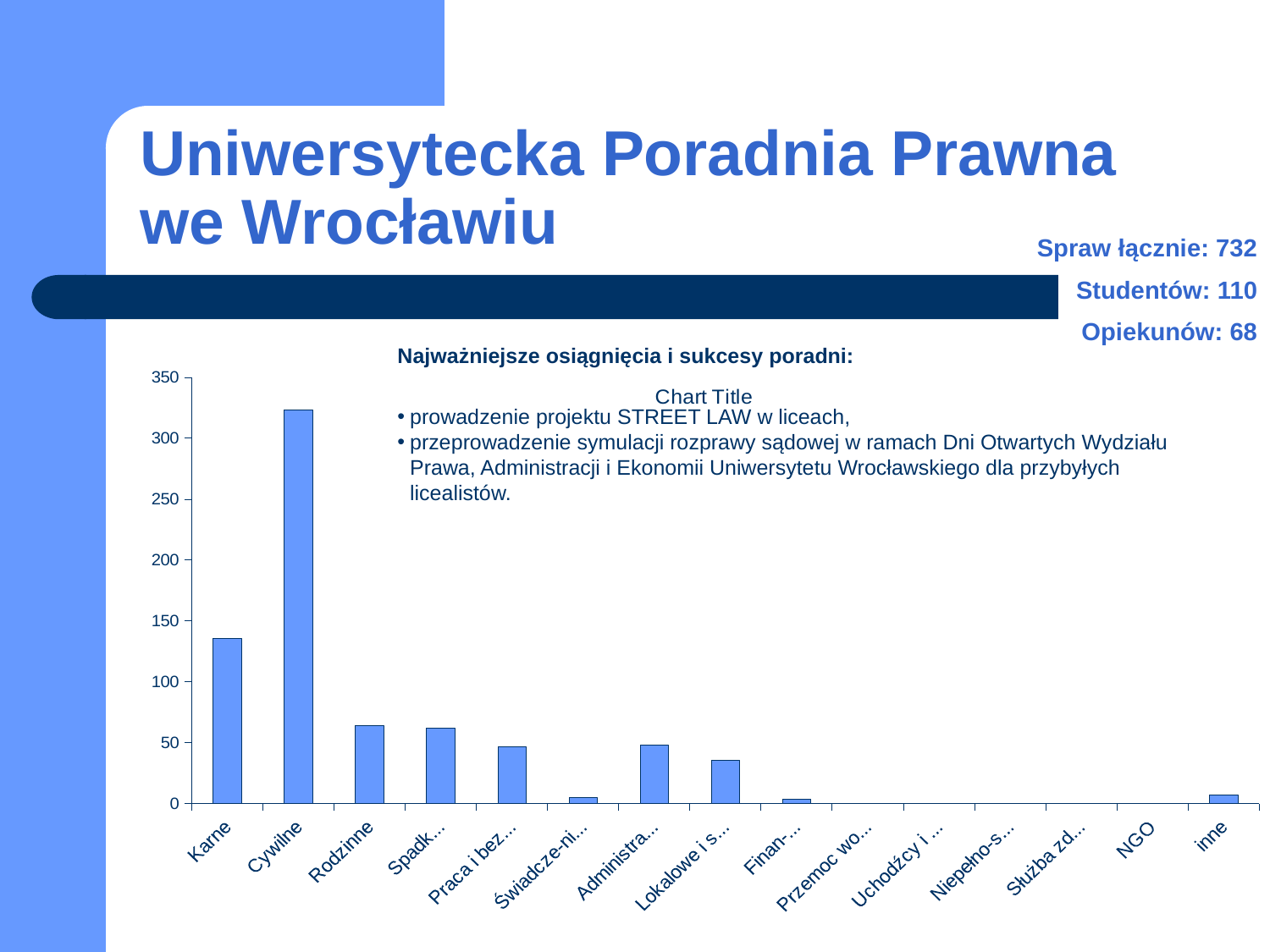
Is the value for Karne greater or less than 150? less Is the value for Cywilne greater or less than 300? greater Which is larger, the value for Karne or the value for Rodzinne? Karne Which is larger, the value for Rodzinne or the value for Lokalowe i s...? Rodzinne What kind of chart is shown on the slide? bar chart Which is larger, the value for Karne or the value for Cywilne? Cywilne Is the value for Lokalowe i s... greater or less than 50? less How many categories are shown on the x axis of the chart? 15 Which category has the highest bar in the chart? Cywilne What is the title shown above the chart? Chart Title